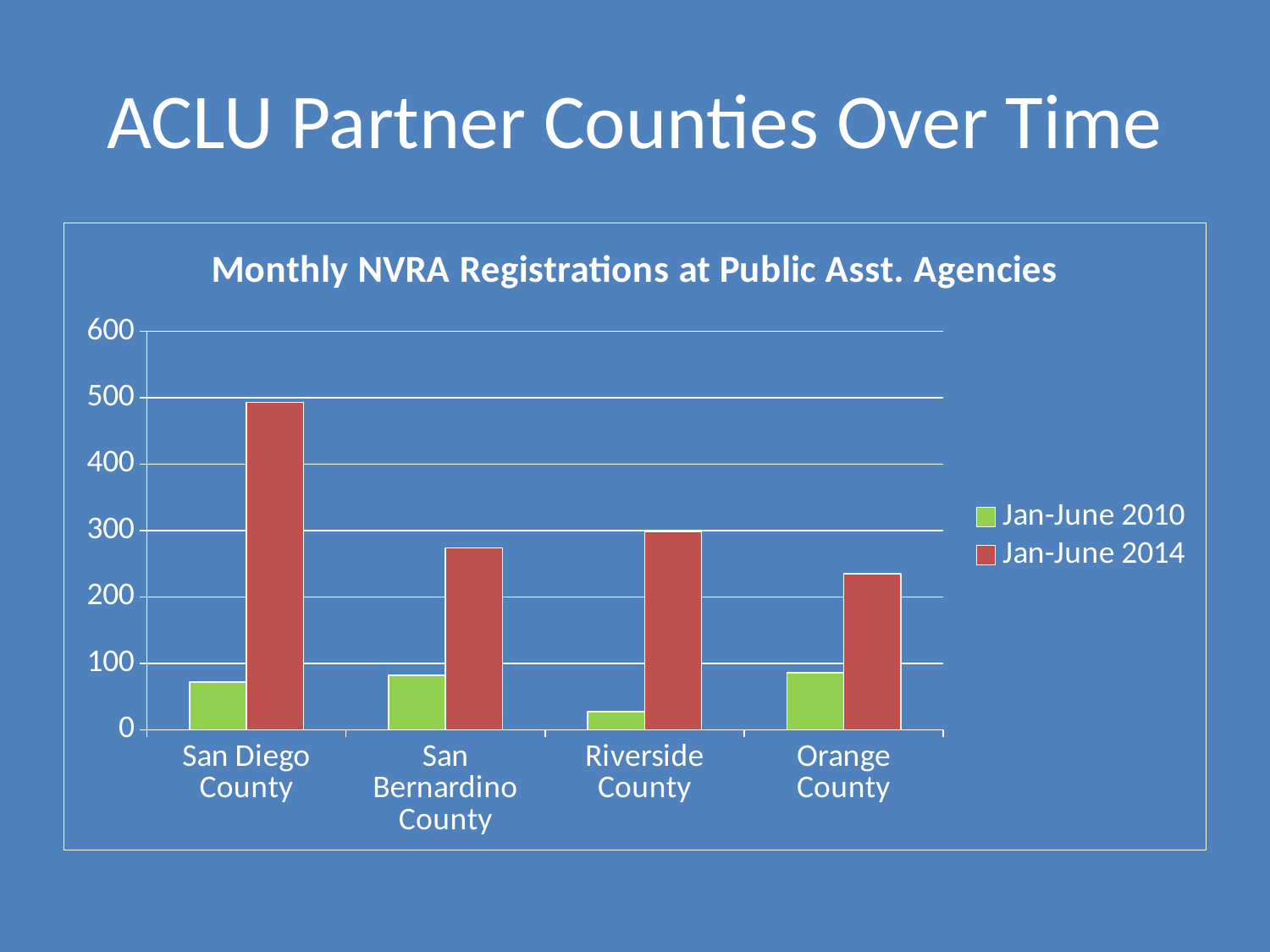
What kind of chart is shown on the slide? bar chart For Riverside County, which is larger: the Jan-June 2010 value or the Jan-June 2014 value? Jan-June 2014 How many counties are shown on the x axis? 4 Which county has the lowest value for Jan-June 2010? Riverside County Which county has the lowest value for Jan-June 2014? Orange County Is the Jan-June 2014 value for San Bernardino County greater or less than 300? less Which county has the highest value for Jan-June 2014? San Diego County Is the Jan-June 2010 value for Riverside County greater or less than 100? less How many series does the legend list? 2 What is the title of the chart? Monthly NVRA Registrations at Public Asst. Agencies Is the Jan-June 2014 value for San Diego County greater or less than 400? greater